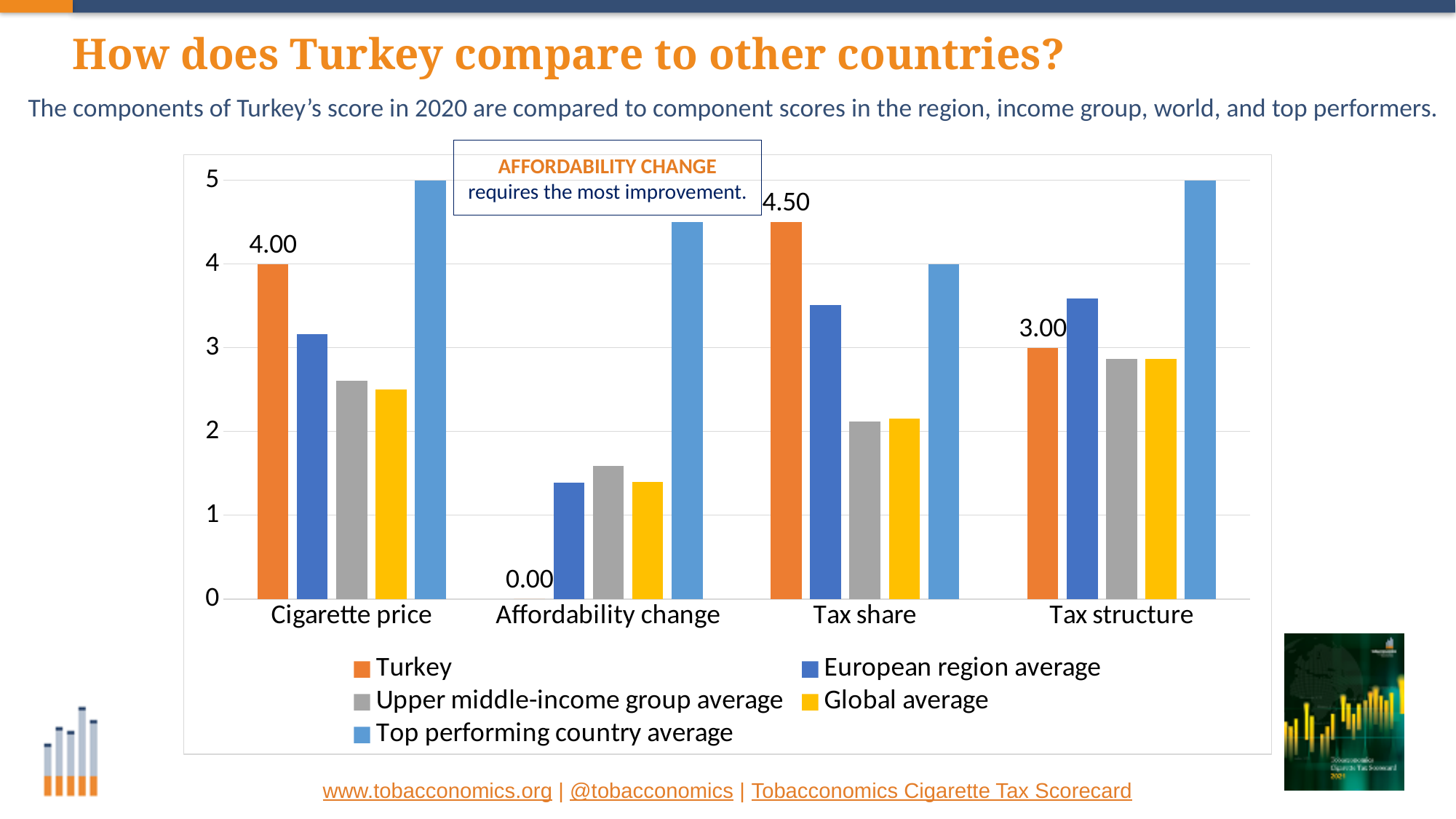
What is the difference between Turkey's Tax share score and its Tax structure score? 1.50 Which is larger for Tax structure: Turkey or the European region average? European region average In which component does Turkey have its highest score? Tax share How many component categories are shown on the x axis? 4 What type of chart is shown on the slide? Bar chart What is Turkey's score for Affordability change? 0.00 What is Turkey's score for Cigarette price? 4.00 What is Turkey's score for Tax share? 4.50 Is the Top performing country average for Tax share greater or less than 3? greater How many series does the legend list? 5 What is Turkey's score for Tax structure? 3.00 In which component does Turkey have its lowest score? Affordability change